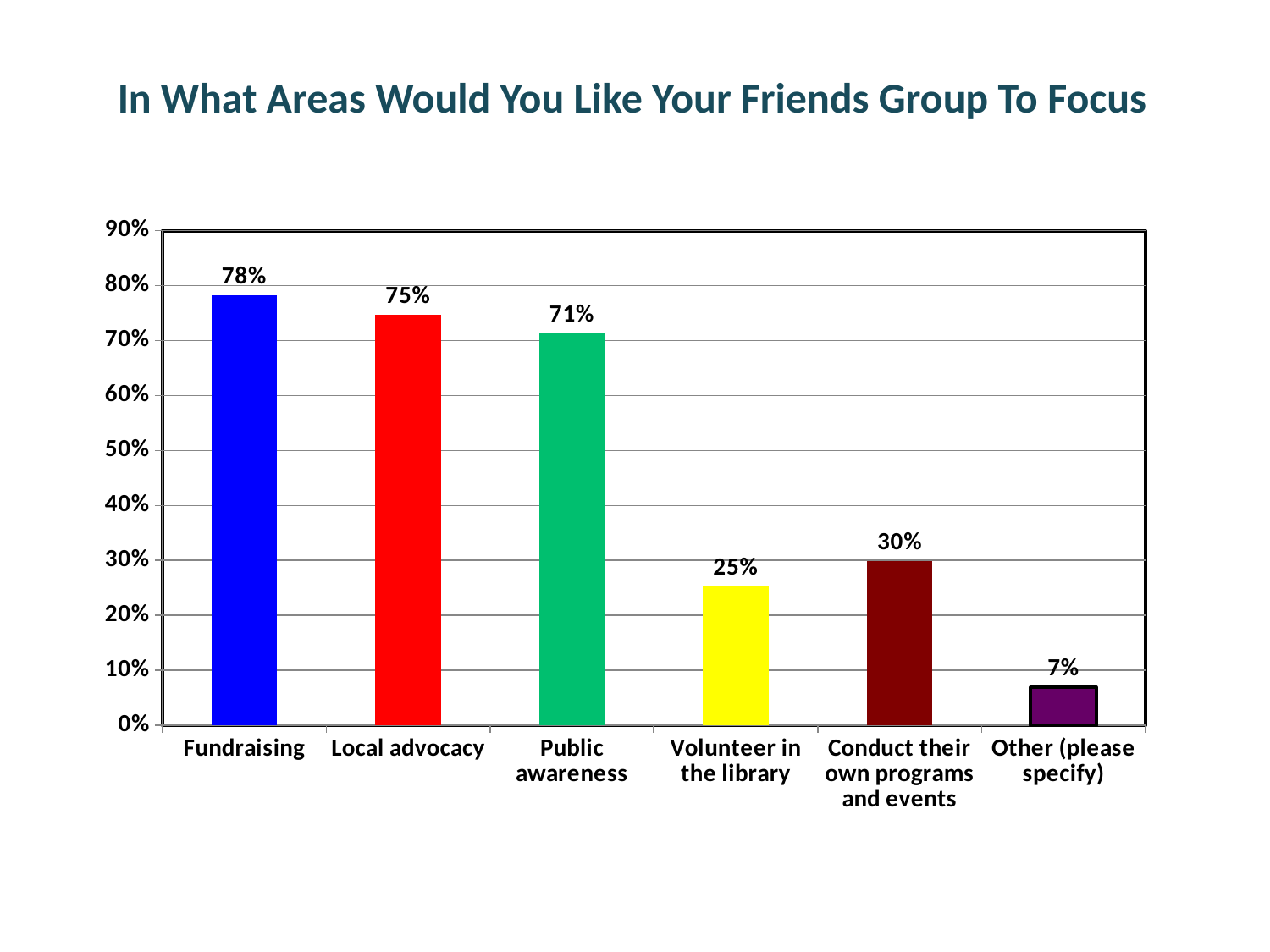
What is the difference between the values for Fundraising and Public awareness? 7% What kind of chart is shown on the slide? bar chart Which category has the lowest value? Other (please specify) Which category has the highest value? Fundraising What is the value for Conduct their own programs and events? 30% What is the value for Volunteer in the library? 25% What is the difference between the values for Conduct their own programs and events and Volunteer in the library? 5% Is the value for Local advocacy greater or less than 70%? greater What is the title of the chart? In What Areas Would You Like Your Friends Group To Focus What is the value for Fundraising? 78% Which is larger, the value for Local advocacy or the value for Public awareness? Local advocacy How many categories are shown on the x axis? 6